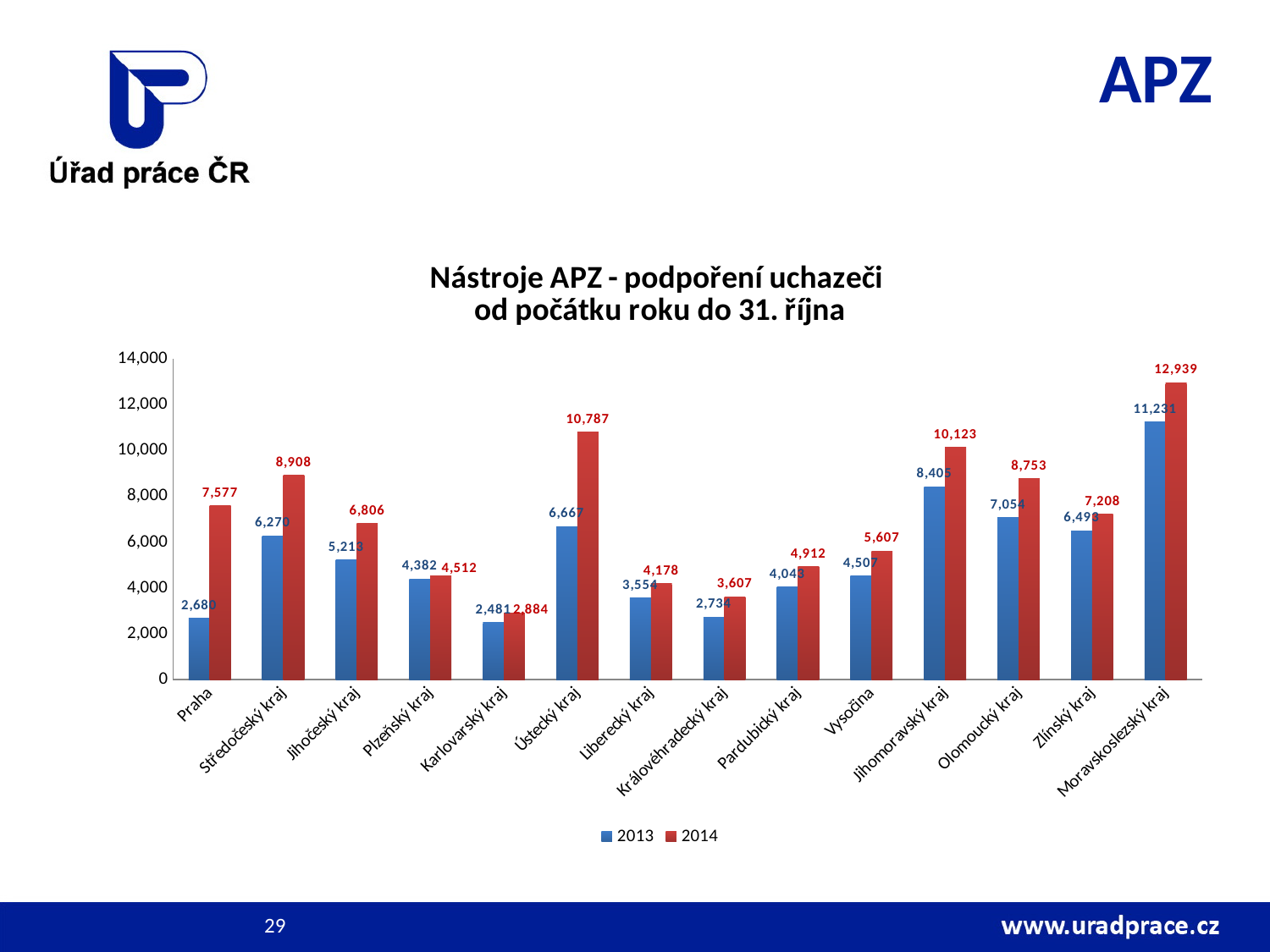
How many series does the legend list? 2 What is the difference between the 2014 values for Ústecký kraj and Liberecký kraj? 6,609 What is the 2014 value for Moravskoslezský kraj? 12,939 What is the 2014 value for Ústecký kraj? 10,787 What kind of chart is shown on the slide? bar chart How many regions are shown on the x axis? 14 What is the 2013 value for Plzeňský kraj? 4,382 Which has the larger 2014 value, Praha or Středočeský kraj? Středočeský kraj Is the 2014 value for Jihomoravský kraj greater or less than 10,000? greater Which region has the lowest 2014 value? Karlovarský kraj Which region has the highest 2014 value? Moravskoslezský kraj By how much did the value for Karlovarský kraj increase from 2013 to 2014? 403